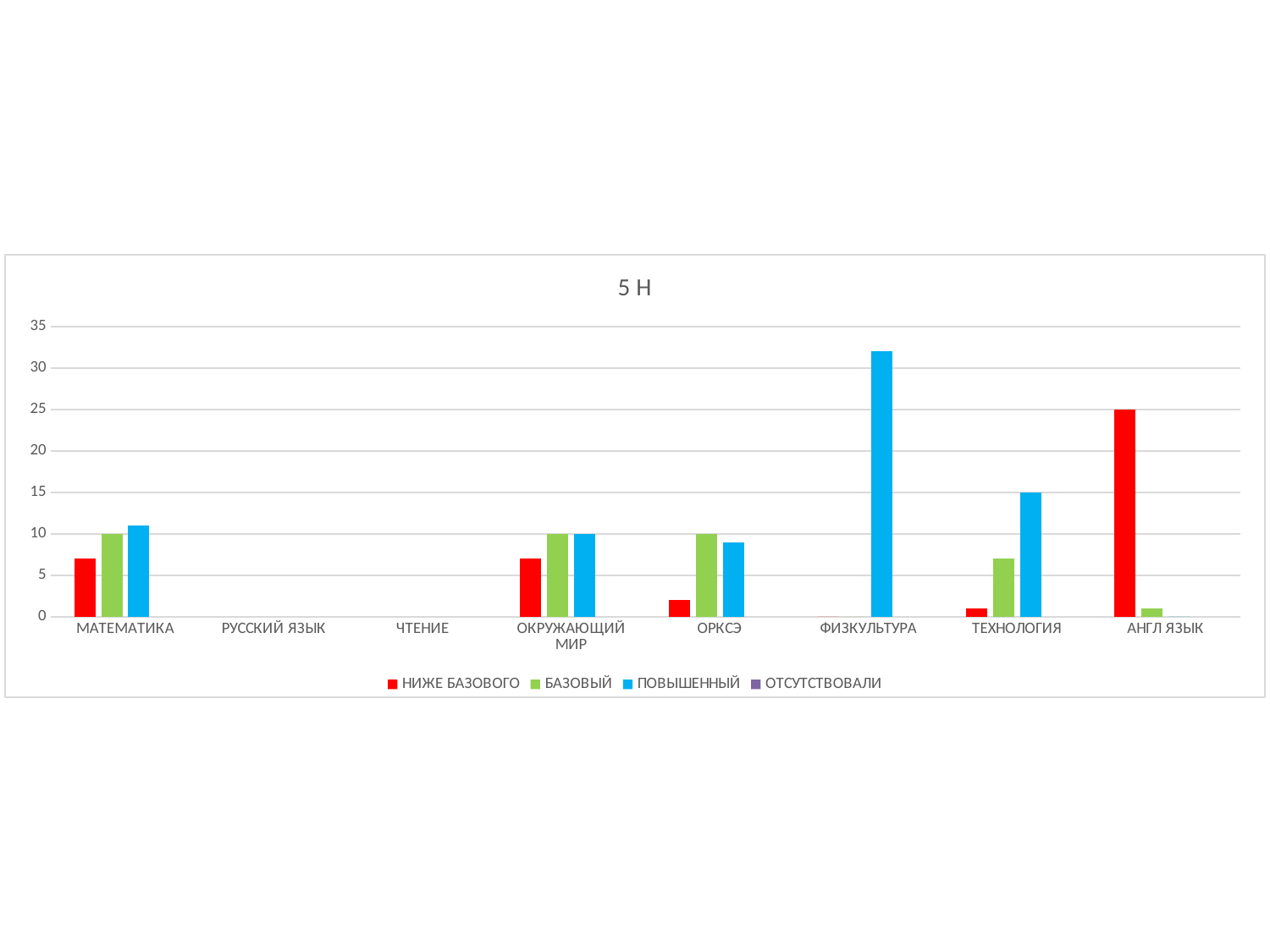
How many series does the legend list? 4 What is the value of БАЗОВЫЙ for МАТЕМАТИКА? 10 Which category has the highest ПОВЫШЕННЫЙ value? ФИЗКУЛЬТУРА How many categories are shown on the x axis? 8 What is the value of НИЖЕ БАЗОВОГО for АНГЛ ЯЗЫК? 25 What is the value of ПОВЫШЕННЫЙ for ТЕХНОЛОГИЯ? 15 Is the value of НИЖЕ БАЗОВОГО for ОРКСЭ greater or less than 5? less Which is larger for ОРКСЭ: БАЗОВЫЙ or НИЖЕ БАЗОВОГО? БАЗОВЫЙ What type of chart is shown on the slide? bar chart What is the difference between the НИЖЕ БАЗОВОГО value for АНГЛ ЯЗЫК and the ПОВЫШЕННЫЙ value for ТЕХНОЛОГИЯ? 10 What is the title of the chart? 5 Н Is the value of ПОВЫШЕННЫЙ for ФИЗКУЛЬТУРА greater or less than 30? greater